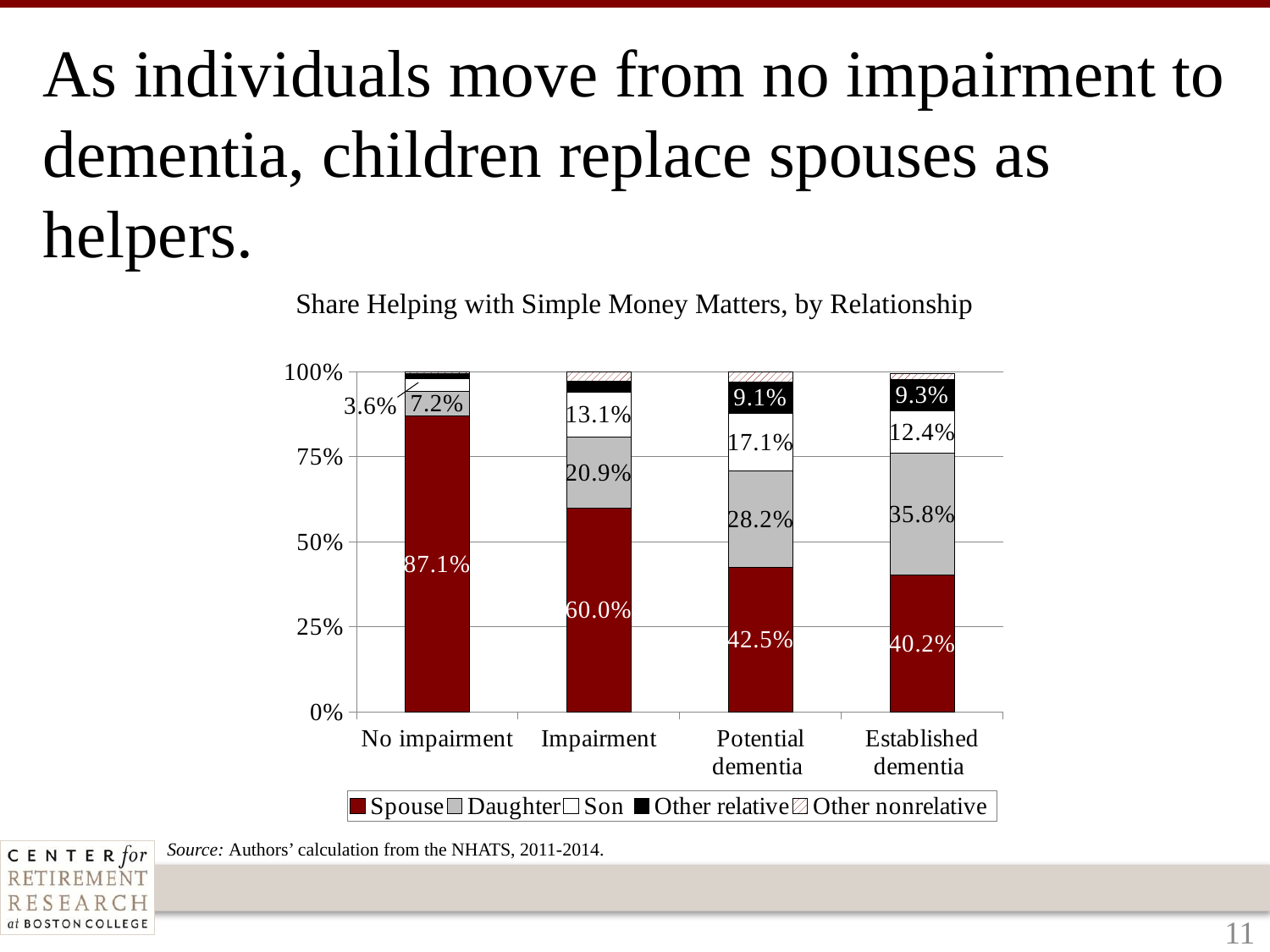
What share of helpers are spouses in the No impairment category? 87.1% What is the Son share for the Impairment category? 13.1% Which category has the larger Daughter share, Potential dementia or Established dementia? Established dementia What is the Other relative share for the Potential dementia category? 9.1% How much larger is the Spouse share for No impairment than for Impairment? 27.1 percentage points What is the Daughter share for the Established dementia category? 35.8% How many categories are shown on the x axis? 4 How many series does the legend list? 5 Which category has the highest Spouse share? No impairment Does the Spouse share rise or fall moving from No impairment to Established dementia? It falls What kind of chart is shown on the slide? Stacked bar chart Which category has the lowest Spouse share? Established dementia